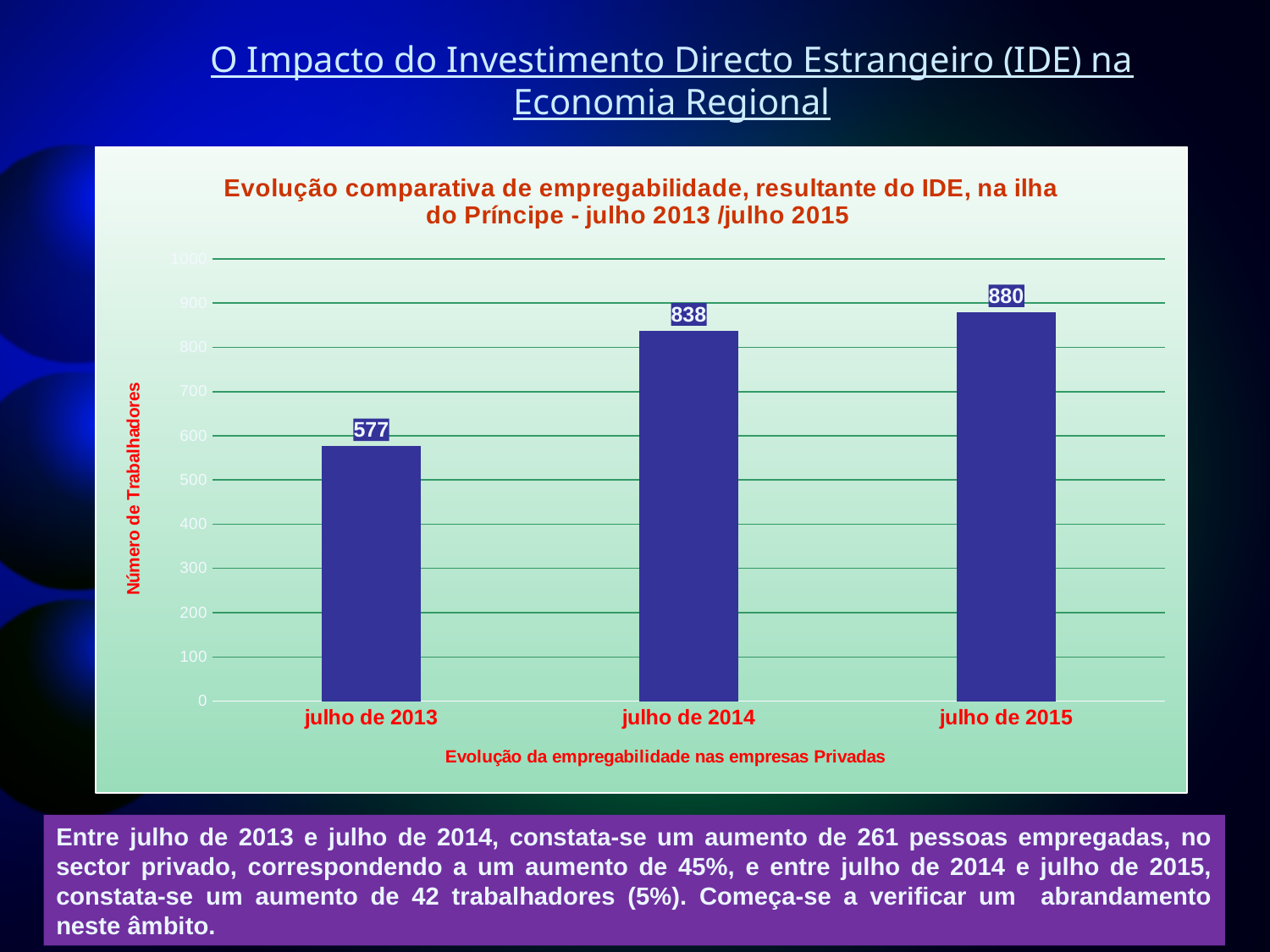
What is the difference between the values for julho de 2014 and julho de 2013? 261 What kind of chart is shown on the slide? bar chart What is the value for julho de 2013? 577 What is the difference between the values for julho de 2015 and julho de 2014? 42 Which is larger, the value for julho de 2013 or the value for julho de 2014? julho de 2014 What is the value for julho de 2015? 880 Which category has the highest value? julho de 2015 Do the values rise or fall from julho de 2013 to julho de 2015? rise How many categories are shown on the x axis? 3 Which category has the lowest value? julho de 2013 What is the value for julho de 2014? 838 Is the value for julho de 2013 greater or less than 600? less